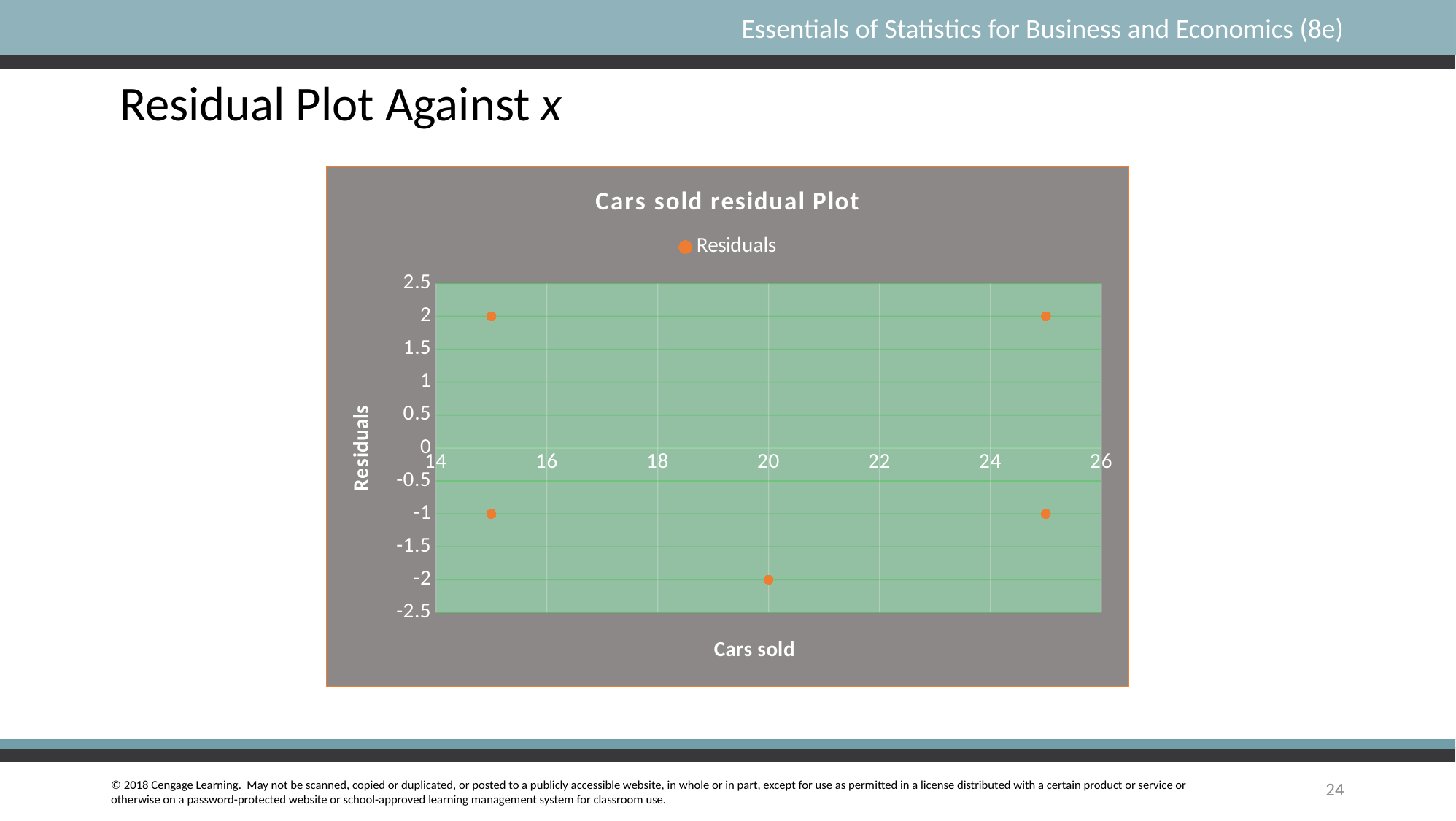
What is the lowest residual value plotted on the chart? -2 Is the residual for the point at 20 cars sold greater or less than 0? less What is the residual value of the point plotted at 20 cars sold? -2 What is the difference between the highest and lowest residual values plotted? 4 What is the highest residual value plotted on the chart? 2 What is the title of the chart? Cars sold residual Plot How many data points are plotted on the chart? 5 What is the label on the horizontal axis of the chart? Cars sold How many points on the chart have a residual of 2? 2 What kind of chart is shown on the slide? scatter plot How many series does the legend list? 1 How many points on the chart have a residual of -1? 2